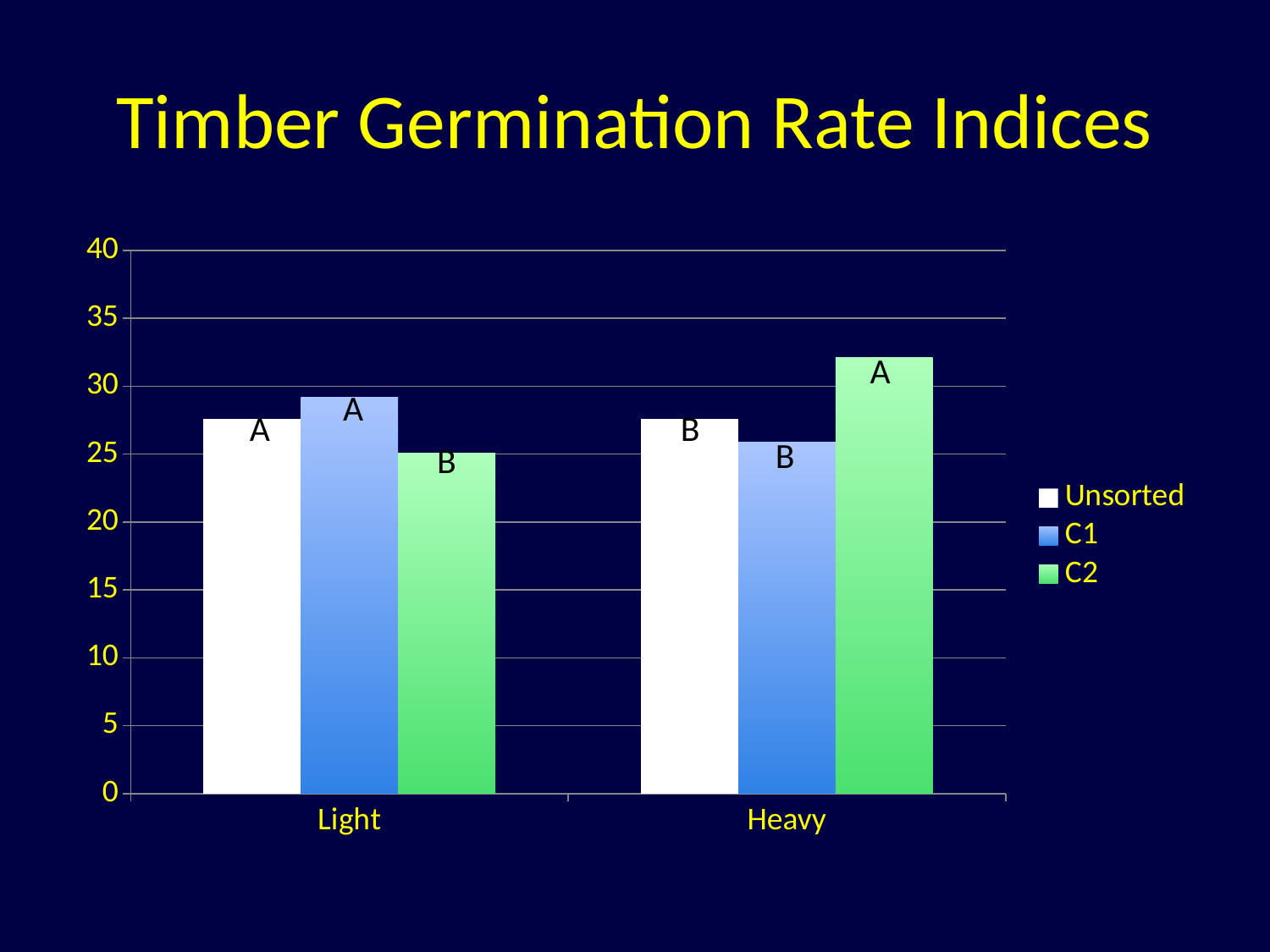
Which series has the highest bar in the Heavy category? C2 What kind of chart is shown on the slide? bar chart Is the C2 value for Light greater or less than 30? less Which series has the lowest bar in the Heavy category? C1 Which is larger, the C2 value for Light or the C2 value for Heavy? Heavy How many series does the legend list? 3 Which series is shown in green in the legend? C2 Is the C2 value for Heavy greater or less than 30? greater How many categories are shown on the x axis? 2 Which series has the highest bar in the Light category? C1 Which series has the lowest bar in the Light category? C2 What is the title of the chart? Timber Germination Rate Indices